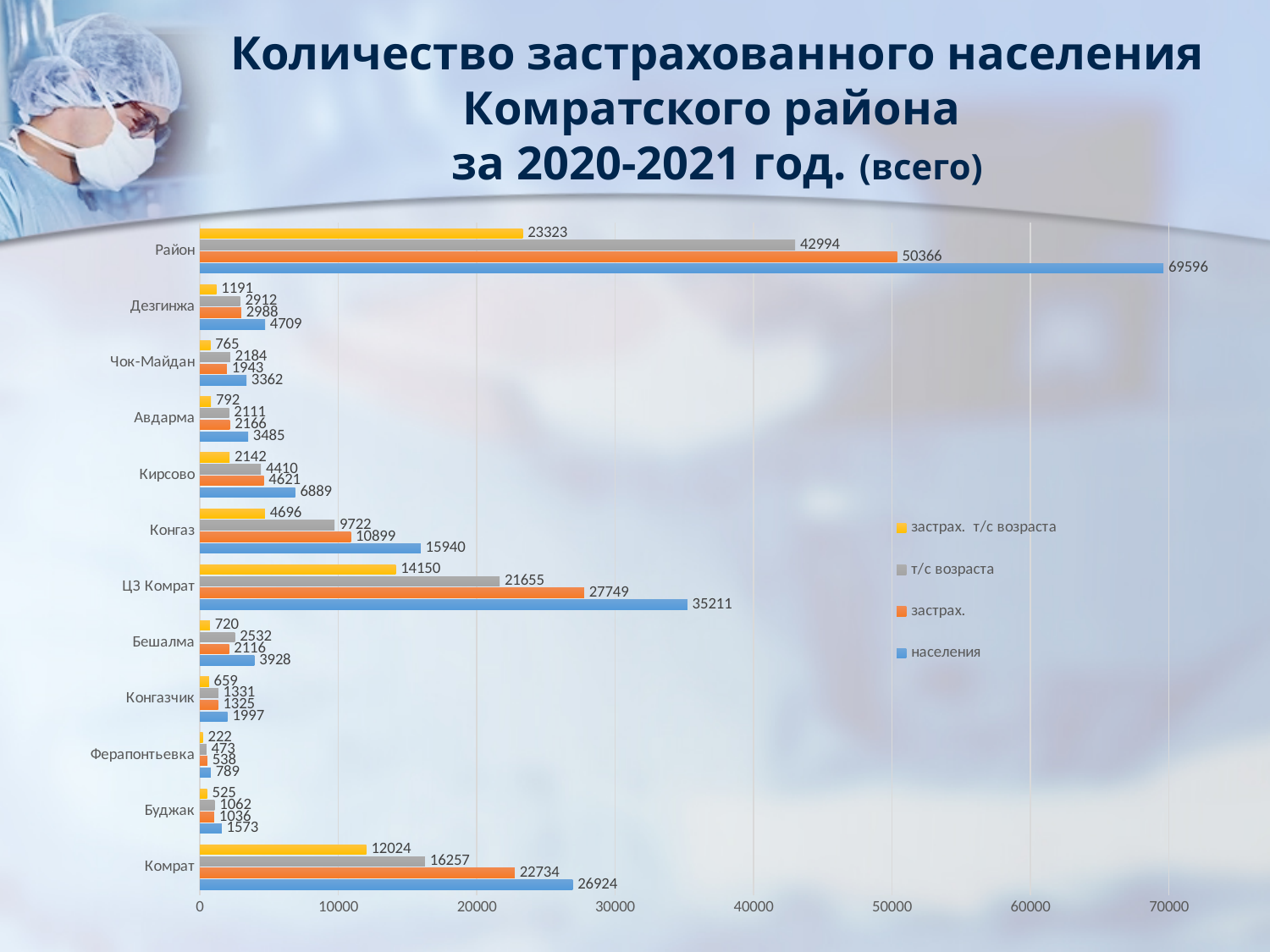
What is the value of 'т/с возраста' for Конгаз? 9722 What is the value of 'застрах. т/с возраста' for Комрат? 12024 How many categories are plotted on the chart? 12 Excluding Район, which category has the highest 'застрах.' value? ЦЗ Комрат Which is larger for Кирсово: 'застрах.' or 'т/с возраста'? застрах. What is the value of 'застрах.' for ЦЗ Комрат? 27749 What kind of chart is shown on the slide? bar chart Which category has the lowest 'населения' value? Ферапонтьевка What is the value of 'населения' for Район? 69596 Which series is shown in yellow in the legend? застрах. т/с возраста What is the difference between the 'населения' value and the 'застрах.' value for Район? 19230 How many series does the legend list? 4